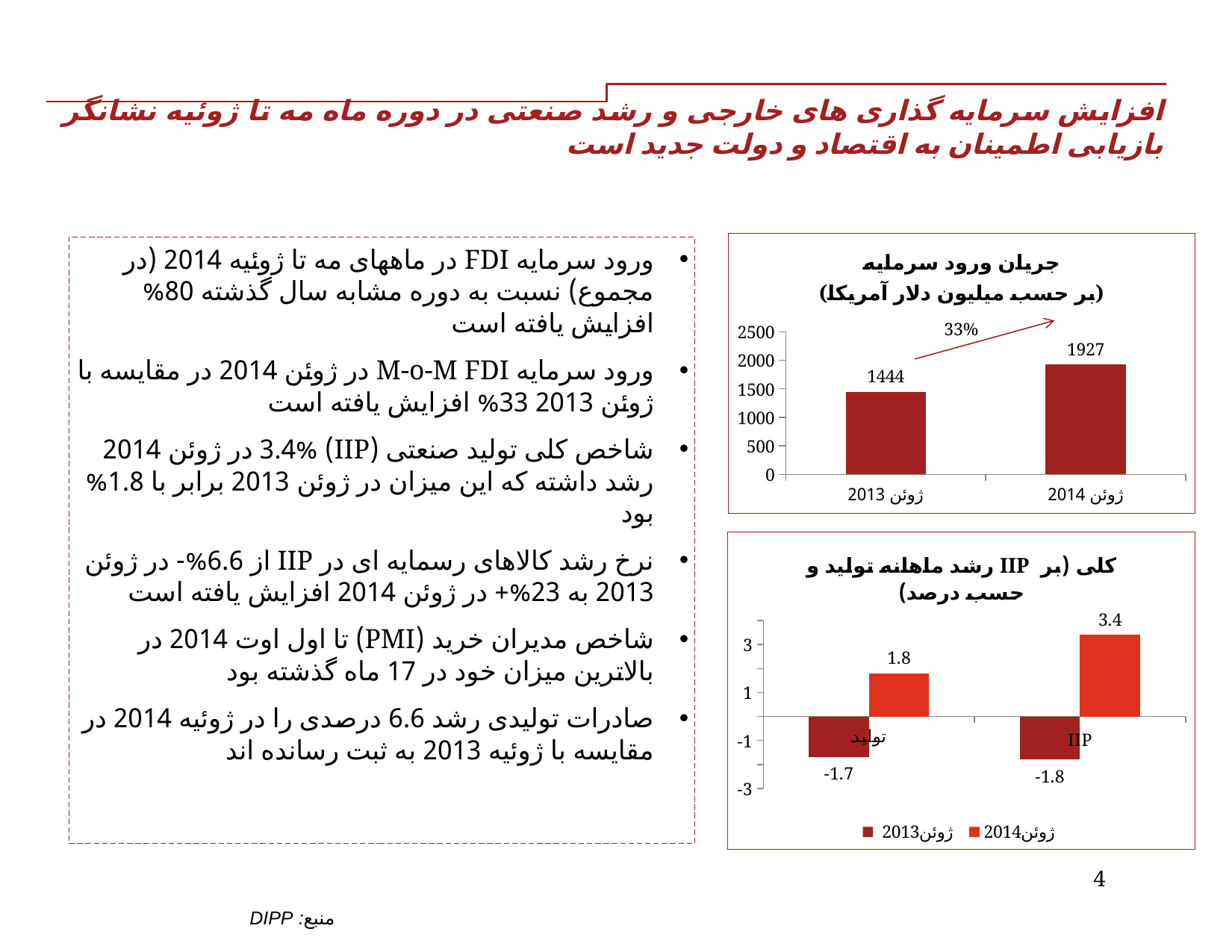
In the bottom chart (monthly growth of production and overall IIP), what is the value for IIP in the June 2014 (ژوئن2014) series? 3.4 In the bottom chart (monthly growth of production and overall IIP), how many series does the legend list? 2 In the top chart (capital inflow), what percentage change is written next to the arrow? 33% In the bottom chart (monthly growth of production and overall IIP), what is the value for IIP in the June 2013 (ژوئن2013) series? -1.8 In the top chart (capital inflow), what is the difference between the June 2014 and June 2013 values? 483 In the top chart (capital inflow, million US dollars), what is the value for June 2013 (ژوئن 2013)? 1444 In the top chart (capital inflow), how many bars are plotted? 2 In the bottom chart (monthly growth of production and overall IIP), what is the value for production (تولید) in the June 2013 (ژوئن2013) series? -1.7 In the top chart (capital inflow), which category has the higher value, June 2013 or June 2014? June 2014 (ژوئن 2014) In the bottom chart (monthly growth of production and overall IIP), which bar has the lowest value? IIP, June 2013 (-1.8) What kind of chart is the bottom chart (monthly growth of production and overall IIP)? Bar chart In the top chart (capital inflow, million US dollars), what is the value for June 2014 (ژوئن 2014)? 1927